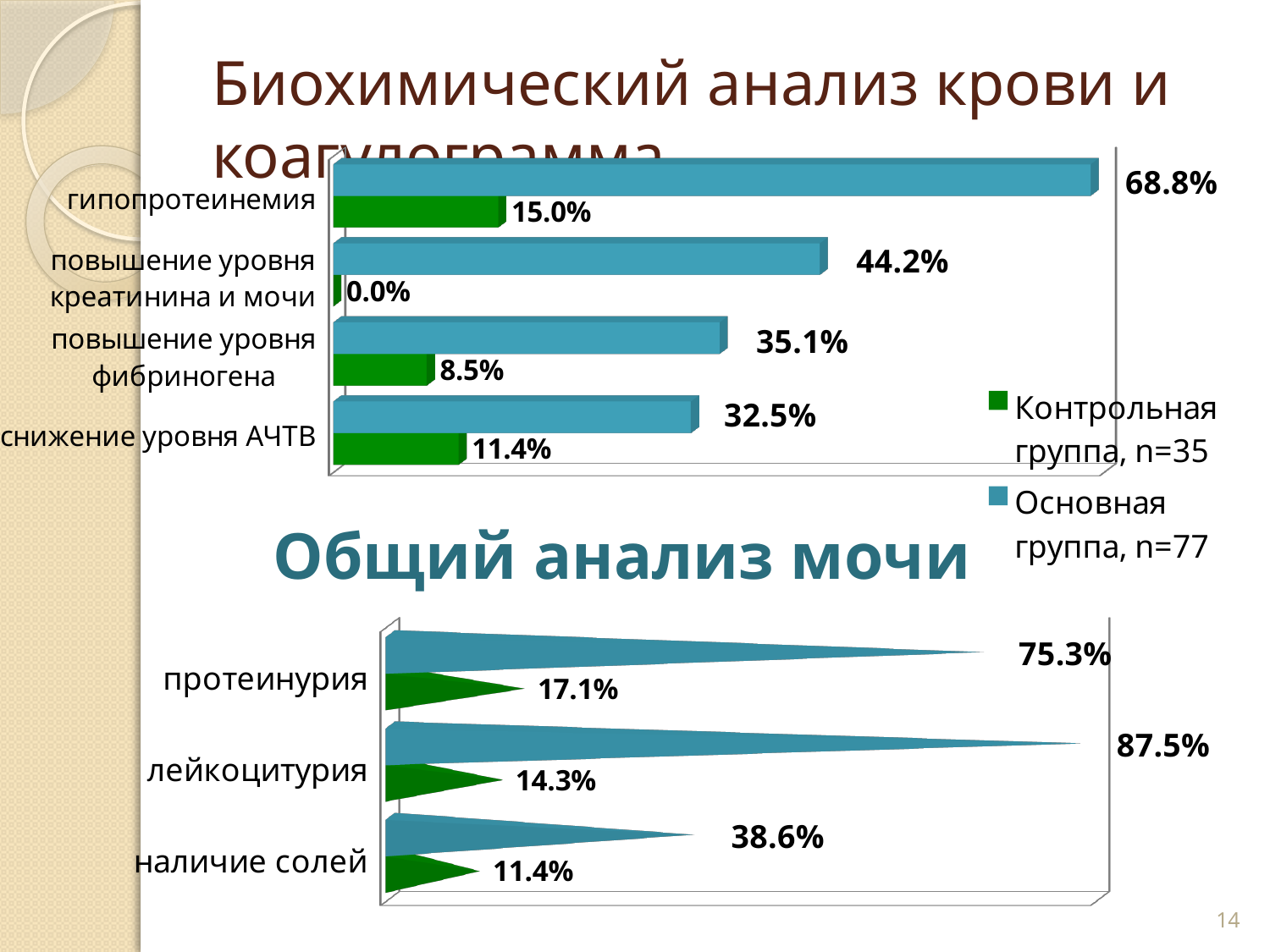
In the bottom chart, what is the value for наличие солей in the Контрольная группа, n=35? 11.4% What kind of chart is the top chart? bar chart In the top chart, what is the difference between the Основная группа and Контрольная группа values for снижение уровня АЧТВ? 21.1% In the top chart, what is the value for повышение уровня креатинина и мочи in the Контрольная группа, n=35? 0.0% In the top chart, how many categories are shown? 4 In the bottom chart, which category has the lowest value for the Основная группа, n=77? наличие солей In the top chart, which category has the highest value for the Основная группа, n=77? гипопротеинемия In the top chart (Биохимический анализ крови и коагулограмма), what is the value for гипопротеинемия in the Основная группа, n=77? 68.8% How many series does the legend list? 2 In the bottom chart, which is larger for протеинурия: the Основная группа value or the Контрольная группа value? Основная группа In the bottom chart (Общий анализ мочи), what is the value for лейкоцитурия in the Основная группа, n=77? 87.5% In the bottom chart, what is the difference between the Основная группа and Контрольная группа values for протеинурия? 58.2%